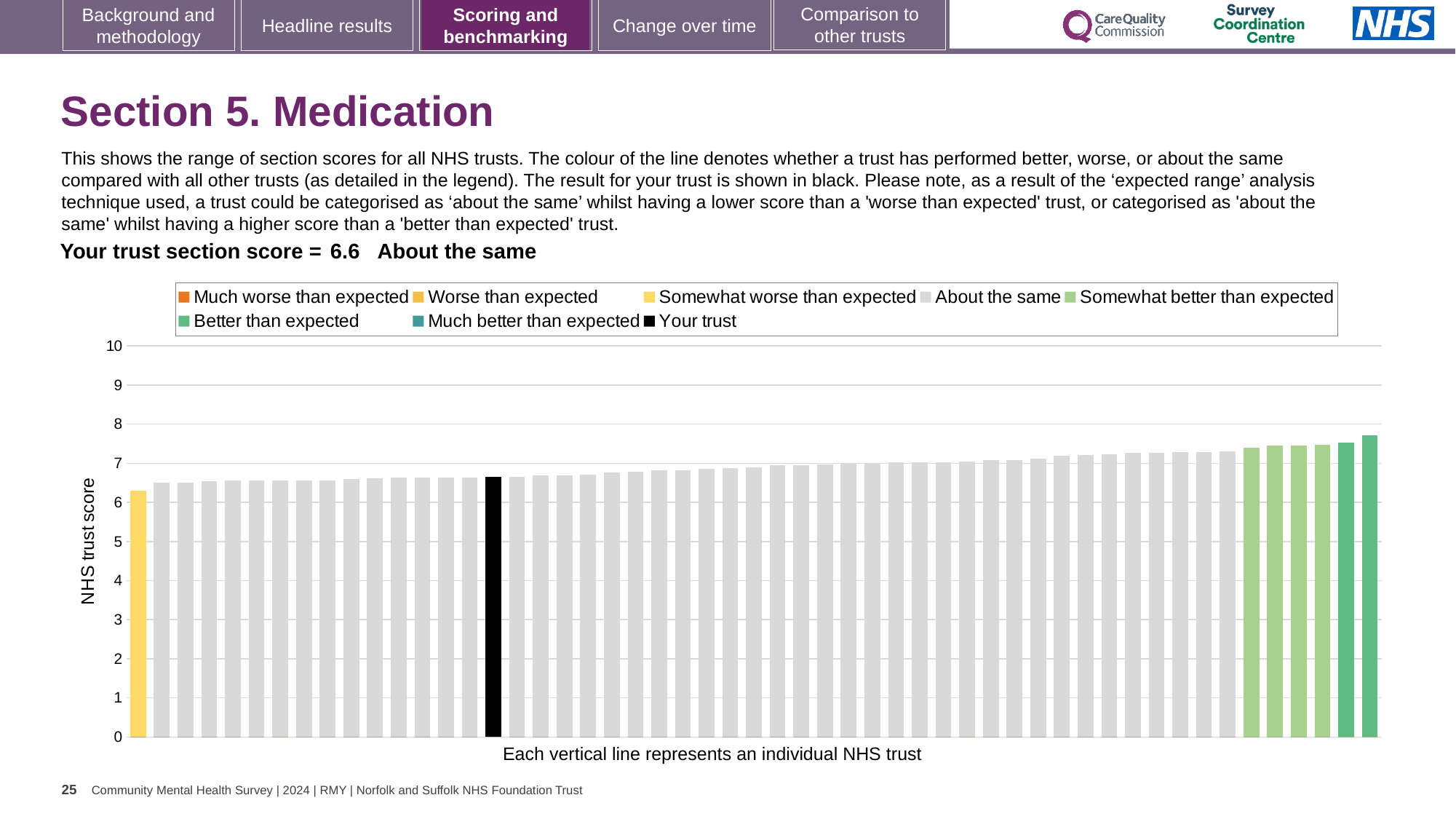
Which is higher: your trust's black bar or the yellow 'Worse than expected' bar? your trust's black bar Which performance category is your trust's section score placed in? About the same What is the label on the vertical axis of the chart? NHS trust score How many entries does the chart legend list? 8 Do the bar values rise or fall from left to right along the x axis? rise Is the value of the lowest bar (yellow) greater or less than 6? greater What kind of chart is shown on the slide? bar chart Is the value of your trust's bar (black) greater or less than 7? less What is the section score for your trust shown on the slide? 6.6 Is the value of the highest bar greater or less than 8? less